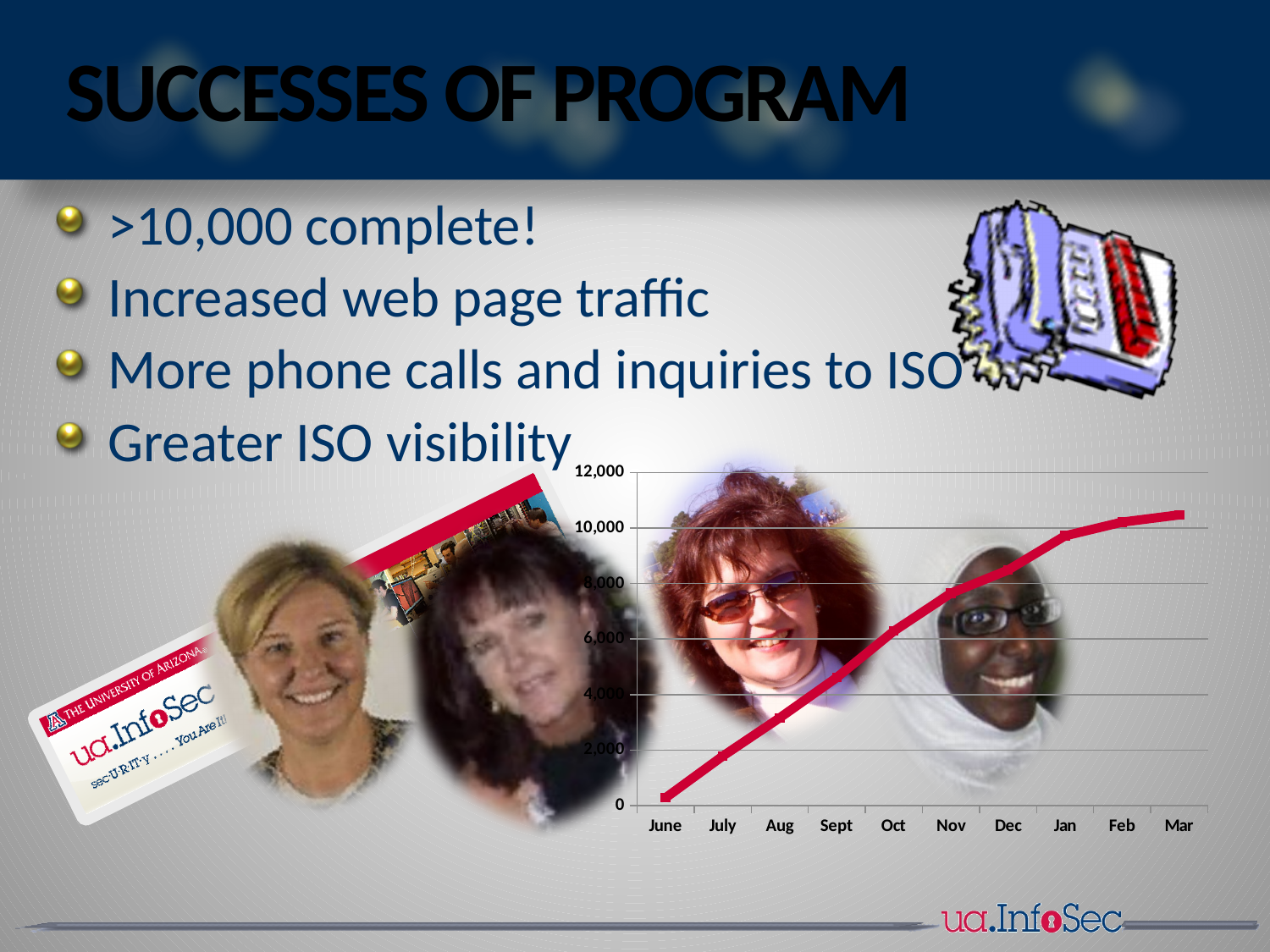
What kind of chart is shown on the slide? line chart Is the value for June greater or less than 2,000? less Do the values in the chart rise or fall from June to Mar? rise How many months are plotted along the x axis of the chart? 10 Is the value for Jan greater or less than 8,000? greater What is the highest value shown on the chart's y axis? 12,000 Is the value for Mar greater or less than 10,000? greater Which month has the highest value in the chart? Mar Which month has the larger value, Dec or Aug? Dec Which month has the lowest value in the chart? June